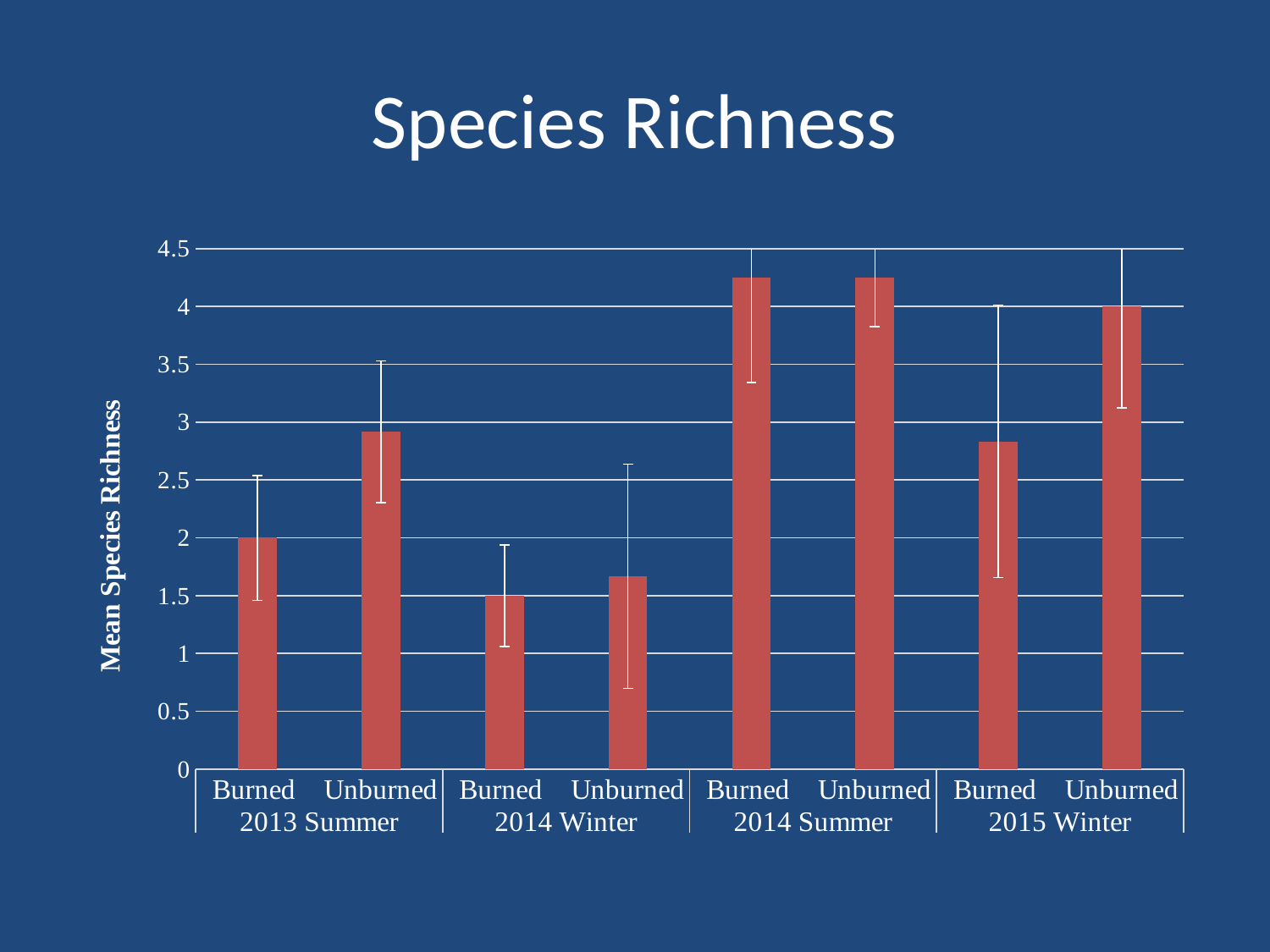
How many bars are plotted in the chart? 8 Is the value for Burned in 2015 Winter greater or less than 3? less What is the title of the y axis? Mean Species Richness Is the value for Unburned in 2013 Summer greater or less than 2.5? greater Is the value for Unburned in 2014 Winter greater or less than 2? less What is the mean species richness for Burned in 2013 Summer? 2 In 2013 Summer, which is larger: Burned or Unburned? Unburned What is the difference between Unburned in 2015 Winter and Burned in 2013 Summer? 2 What is the mean species richness for Unburned in 2015 Winter? 4 What is the mean species richness for Burned in 2014 Winter? 1.5 Which bar has the lowest mean species richness? Burned, 2014 Winter